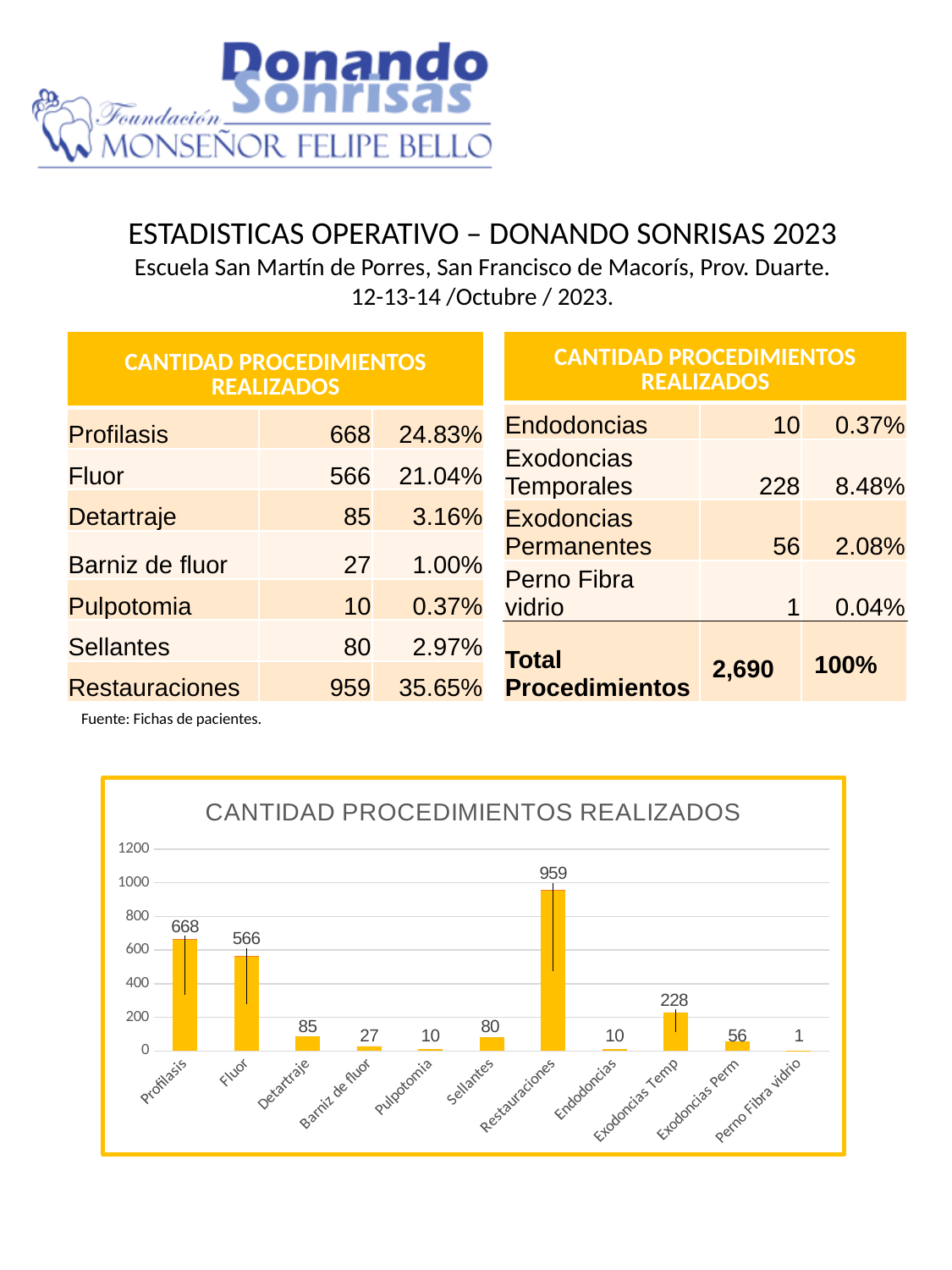
Which is larger, the value for Detartraje or the value for Sellantes? Detartraje What is the difference between the values for Restauraciones and Exodoncias Temp? 731 Is the value for Fluor greater or less than 400? greater What is the value for Exodoncias Temp in the chart? 228 How many categories are shown on the x axis of the chart? 11 What is the value for Restauraciones in the chart? 959 What kind of chart is shown on the slide? bar chart What is the value for Barniz de fluor in the chart? 27 Which category has the lowest value in the chart? Perno Fibra vidrio What is the difference between the values for Profilasis and Fluor? 102 Which category has the highest value in the chart? Restauraciones What is the title of the chart? CANTIDAD PROCEDIMIENTOS REALIZADOS